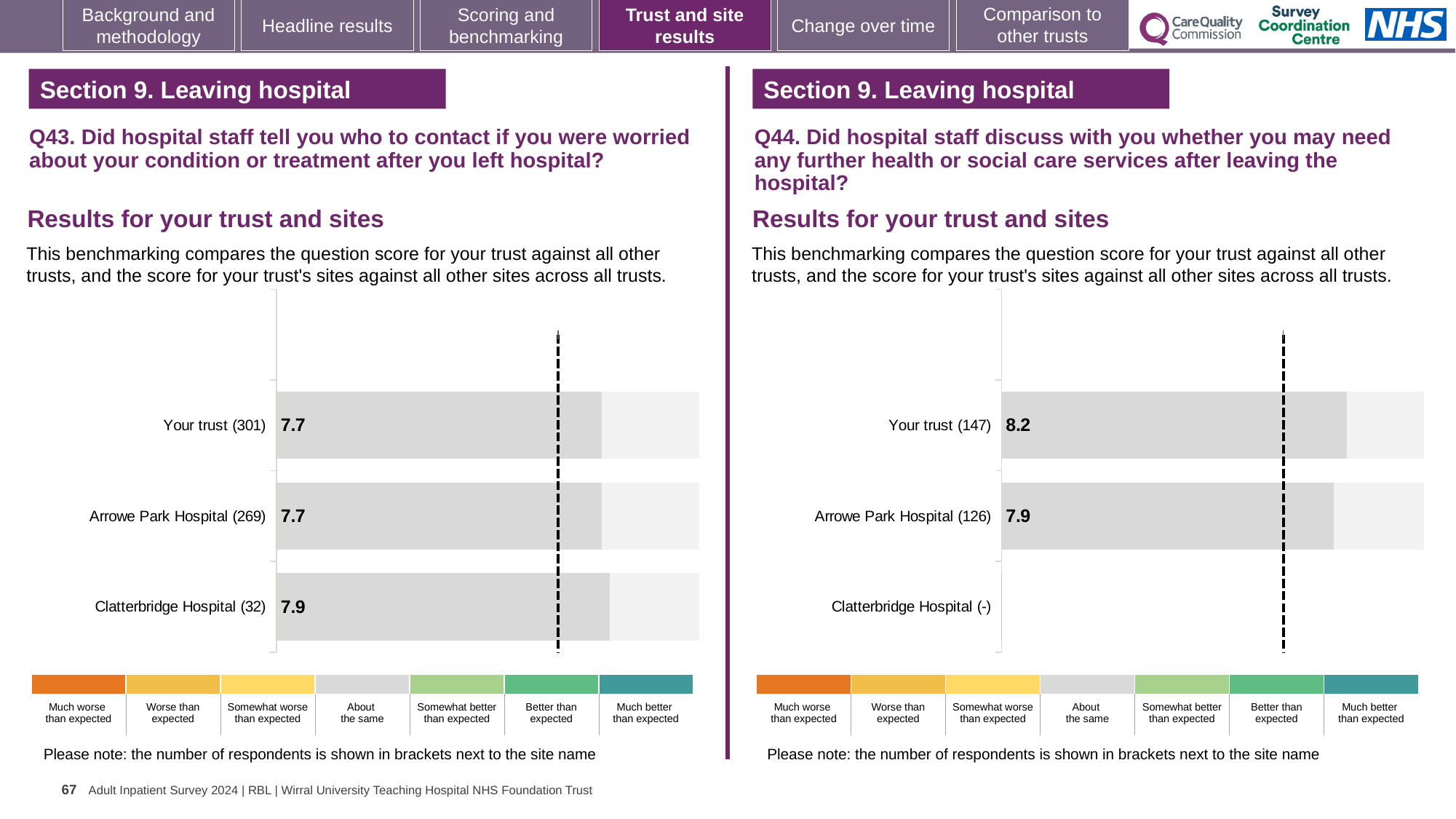
In the Q44 chart on the right, what is the score for Your trust? 8.2 What kind of chart is used in the Q43 chart on the left? Bar chart In the Q43 chart on the left, which site or trust has the highest score? Clatterbridge Hospital In the Q44 chart on the right, what is the score for Arrowe Park Hospital? 7.9 How many categories (trust and sites) are listed in the Q43 chart on the left? 3 In the Q43 chart on the left, what is the score for Your trust? 7.7 In the Q43 chart on the left, how many respondents are shown for Arrowe Park Hospital? 269 In the Q44 chart on the right, what is the difference between the scores for Your trust and Arrowe Park Hospital? 0.3 In the Q44 chart on the right, which has the larger score, Your trust or Arrowe Park Hospital? Your trust In the Q43 chart on the left, what is the score for Clatterbridge Hospital? 7.9 In the Q44 chart on the right, how many respondents are shown for Your trust? 147 In the Q43 chart on the left, what is the difference between the scores for Clatterbridge Hospital and Arrowe Park Hospital? 0.2